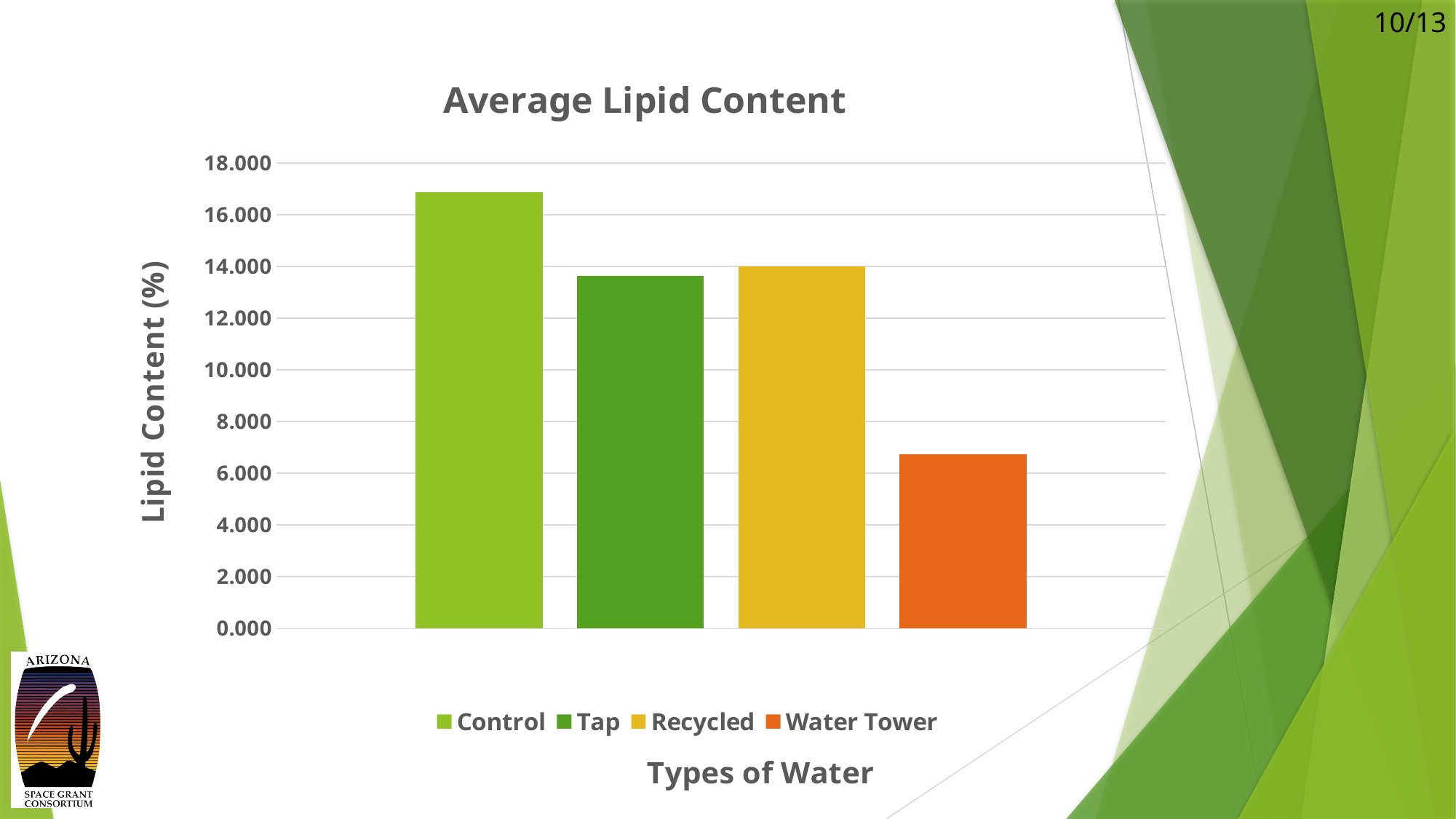
Which type of water has the lowest average lipid content? Water Tower What type of chart is shown on the slide? bar chart What is the label of the y-axis? Lipid Content (%) Is the lipid content for Water Tower greater or less than 8.000? less What is the title of the chart? Average Lipid Content Is the lipid content for Water Tower greater or less than 6.000? greater How many entries does the legend list? 4 Is the lipid content for Tap greater or less than 14.000? less Which type of water has the highest average lipid content? Control Which has a higher lipid content, Control or Water Tower? Control How many types of water are plotted in the chart? 4